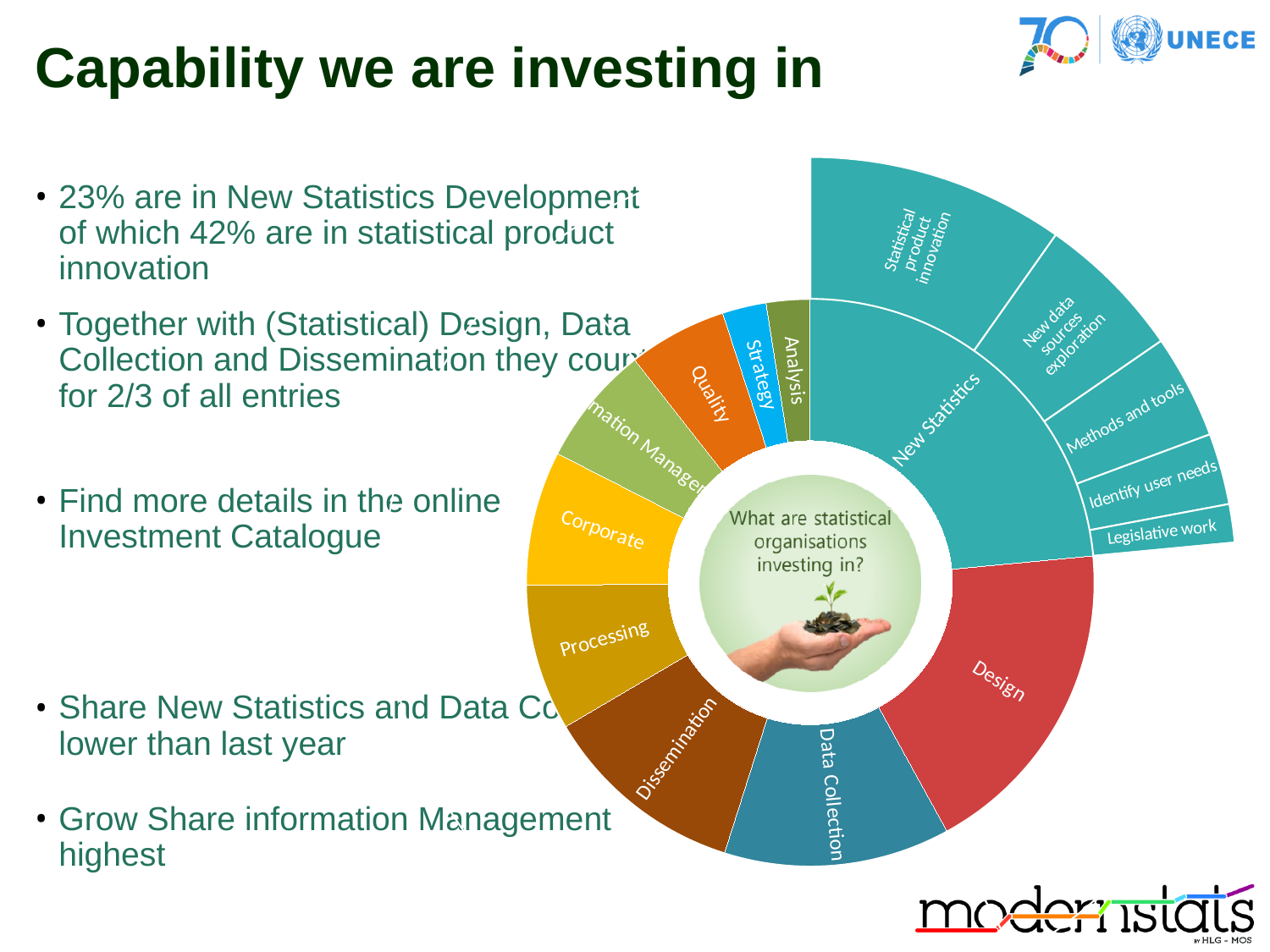
Which sub-category of New Statistics is the largest in the outer ring? Statistical product innovation Which is larger in the chart, New Statistics or Dissemination? New Statistics How many sub-categories does the New Statistics segment break down into in the outer ring? 5 Which is larger in the chart, Processing or Corporate? Processing Which category in the inner ring of the chart is the largest? New Statistics Which inner-ring category is the only one broken down into sub-categories in the outer ring? New Statistics What kind of chart is shown on the slide? Sunburst chart How many categories are shown in the inner ring of the chart? 10 Which is larger in the chart, Design or Data Collection? Design What question is written in the centre of the chart? What are statistical organisations investing in?